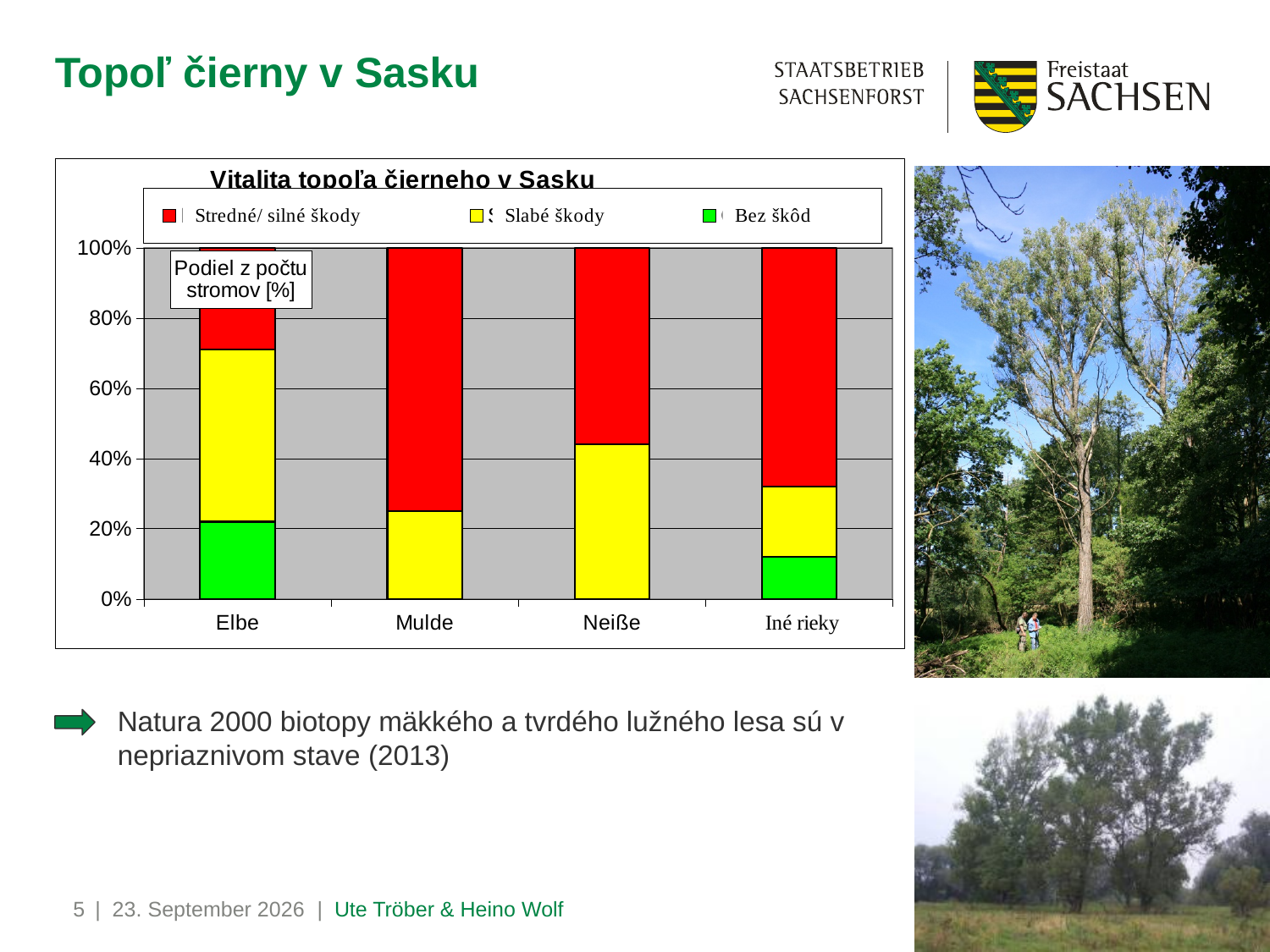
What kind of chart is shown on the slide? Stacked bar chart Which has a larger 'Slabé škody' share, Neiße or Mulde? Neiße Which has a larger 'Bez škôd' share, Elbe or Iné rieky? Elbe What is the title of the chart? Vitalita topoľa čierneho v Sasku Which colour represents the series 'Bez škôd' in the chart? Green Is the 'Bez škôd' share for Elbe greater or less than 40%? less Which category has the largest share of 'Stredné/ silné škody' (red segment)? Mulde How many categories (rivers) are shown on the x axis of the chart? 4 How many series does the chart legend list? 3 Which category has the largest share of 'Bez škôd' (green segment)? Elbe Is the 'Bez škôd' share for Iné rieky greater or less than 20%? less Is the 'Slabé škody' share for Neiße greater or less than 40%? greater